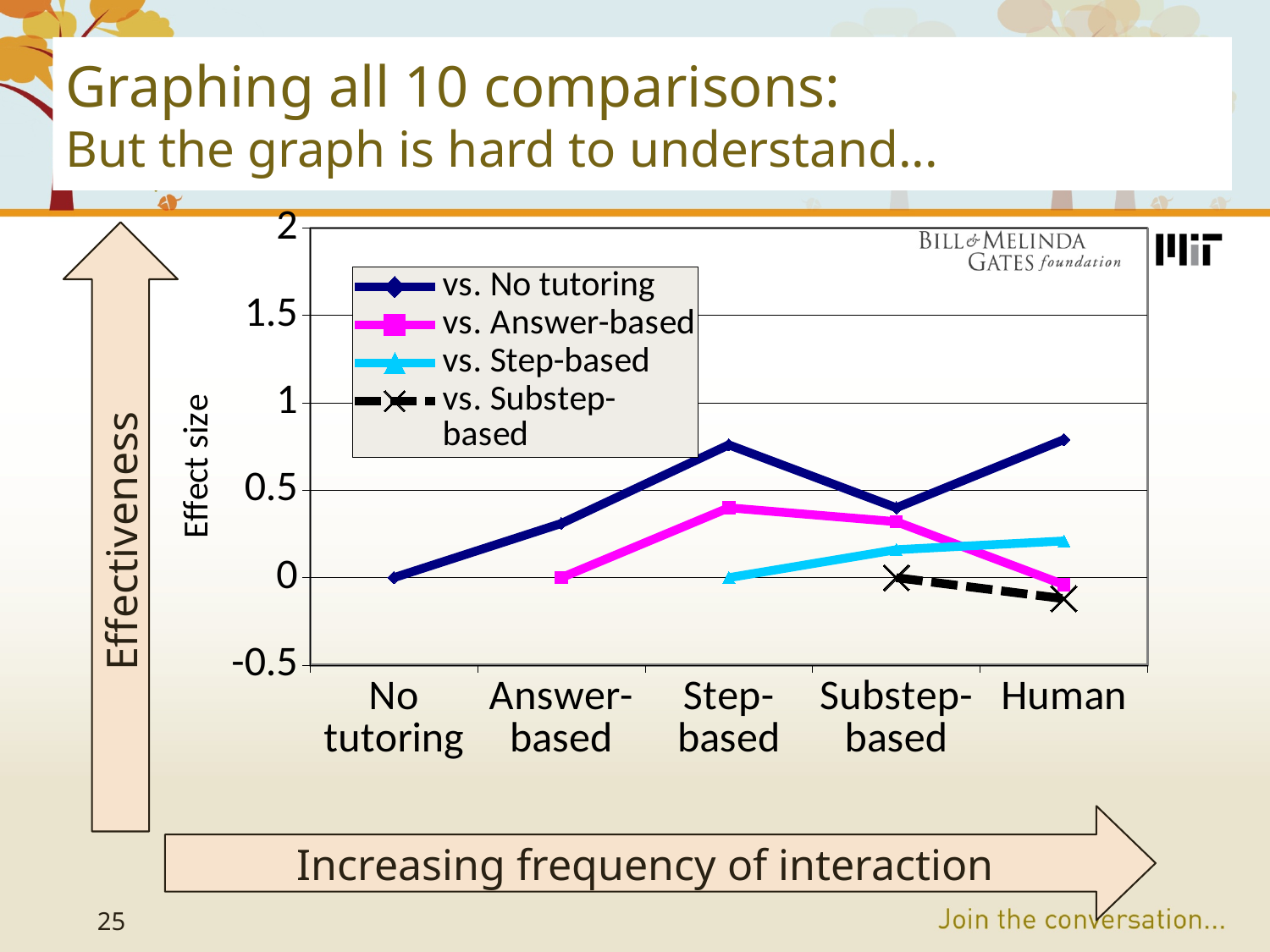
How many series does the legend list? 4 What is the value of the 'vs. No tutoring' series at the 'No tutoring' category? 0 At the 'Step-based' category, which series has the larger value: 'vs. No tutoring' or 'vs. Answer-based'? vs. No tutoring What is the value of the 'vs. Answer-based' series at the 'Answer-based' category? 0 Does the 'vs. Substep-based' series rise or fall from 'Substep-based' to 'Human'? fall How many categories are shown on the x axis? 5 Is the value of the 'vs. Substep-based' series at 'Human' greater or less than 0? less Which category has the lowest value for the 'vs. No tutoring' series? No tutoring What kind of chart is shown on the slide? line chart What is the title of the y axis? Effect size Is the value of the 'vs. No tutoring' series at 'Step-based' greater or less than 0.5? greater Is the value of the 'vs. Answer-based' series at 'Step-based' greater or less than 0.5? less